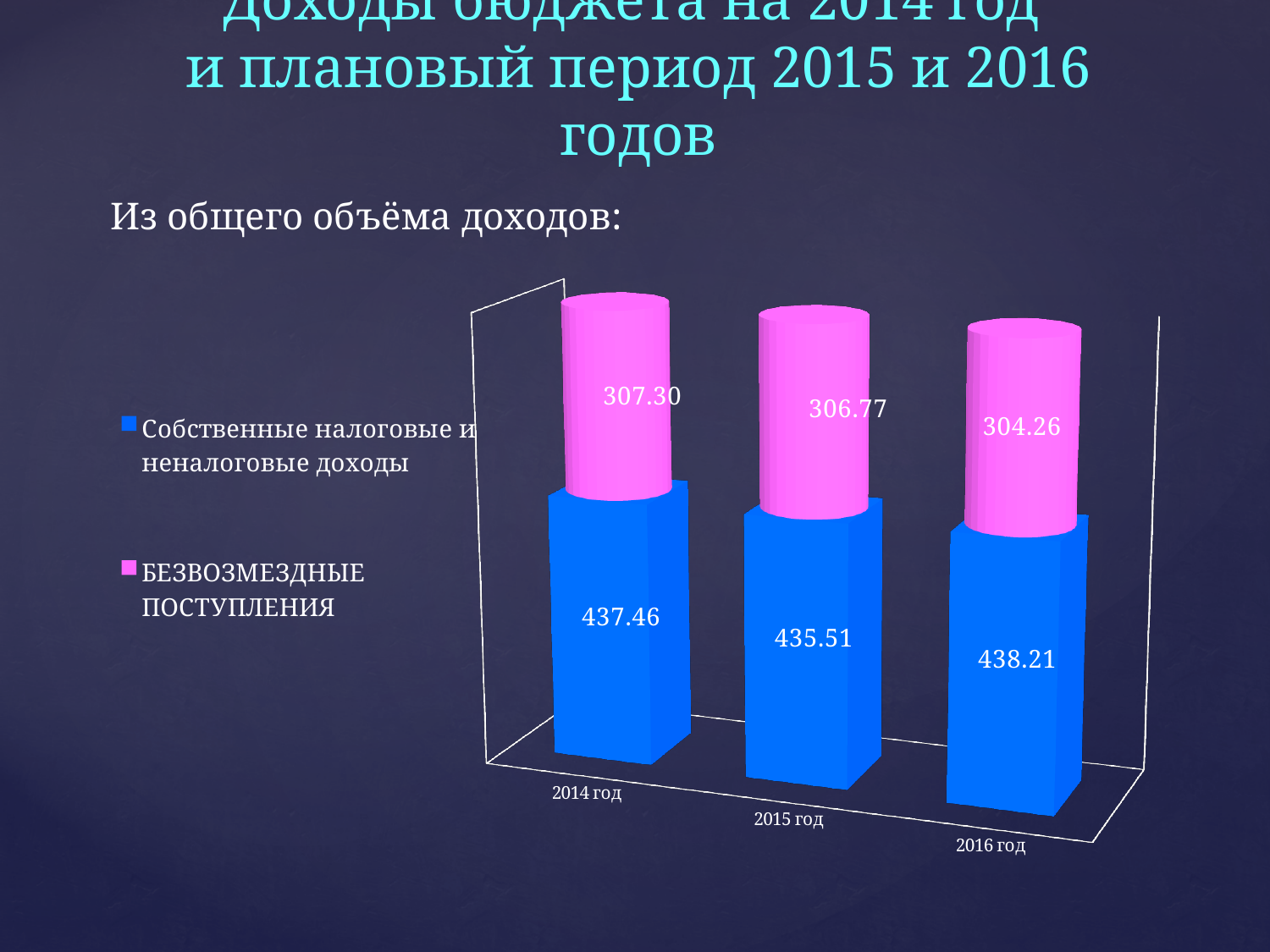
What is the value of Собственные налоговые и неналоговые доходы for 2014 год? 437.46 What kind of chart is shown on the slide? Stacked bar chart What is the value of БЕЗВОЗМЕЗДНЫЕ ПОСТУПЛЕНИЯ for 2016 год? 304.26 How many series does the legend list? 2 Which colour represents БЕЗВОЗМЕЗДНЫЕ ПОСТУПЛЕНИЯ in the chart? Pink In which year is БЕЗВОЗМЕЗДНЫЕ ПОСТУПЛЕНИЯ the lowest? 2016 год What is the total of the stacked bar for 2014 год? 744.76 What is the value of БЕЗВОЗМЕЗДНЫЕ ПОСТУПЛЕНИЯ for 2015 год? 306.77 What is the difference between Собственные налоговые и неналоговые доходы in 2016 год and in 2015 год? 2.70 Which is larger: БЕЗВОЗМЕЗДНЫЕ ПОСТУПЛЕНИЯ in 2014 год or in 2016 год? 2014 год How many years are shown on the x axis? 3 In which year is Собственные налоговые и неналоговые доходы the highest? 2016 год